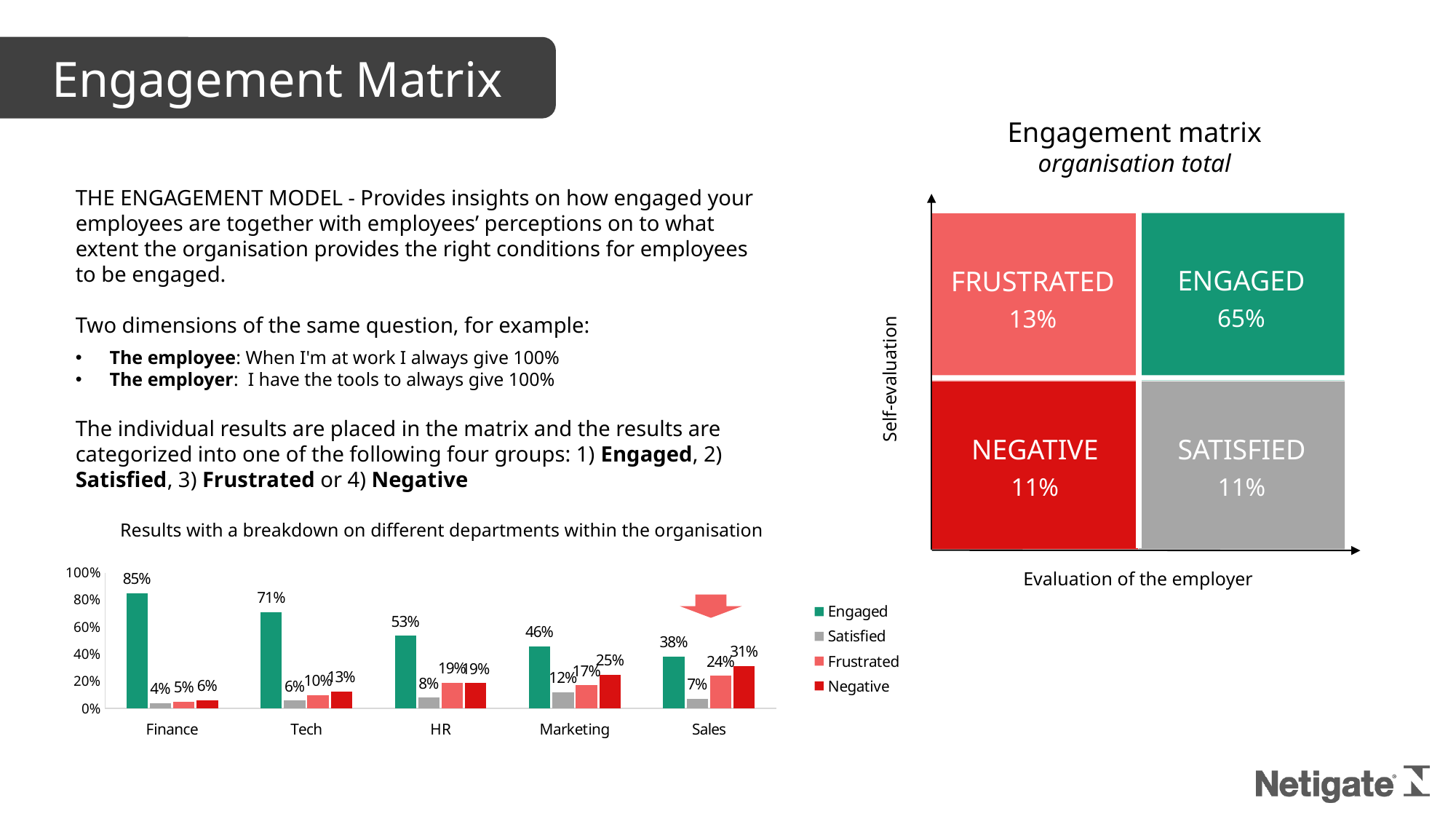
In the bar chart, what is the Negative value for Sales? 31% How many series does the bar chart's legend list? 4 In the bar chart, what is the Frustrated value for HR? 19% In the bar chart, do the Engaged values rise or fall from Finance to Sales? Fall In the bar chart, which department has the highest Engaged value? Finance In the bar chart, which department has the lowest Engaged value? Sales In the bar chart, what is the difference between the Engaged values for Finance and Tech? 14% What kind of chart shows the breakdown by department? Bar chart In the bar chart, how many departments are shown on the x axis? 5 In the bar chart, what is the Engaged value for Finance? 85% In the bar chart, which is larger: the Negative value for Marketing or the Negative value for Tech? Marketing In the bar chart, what is the Satisfied value for Marketing? 12%